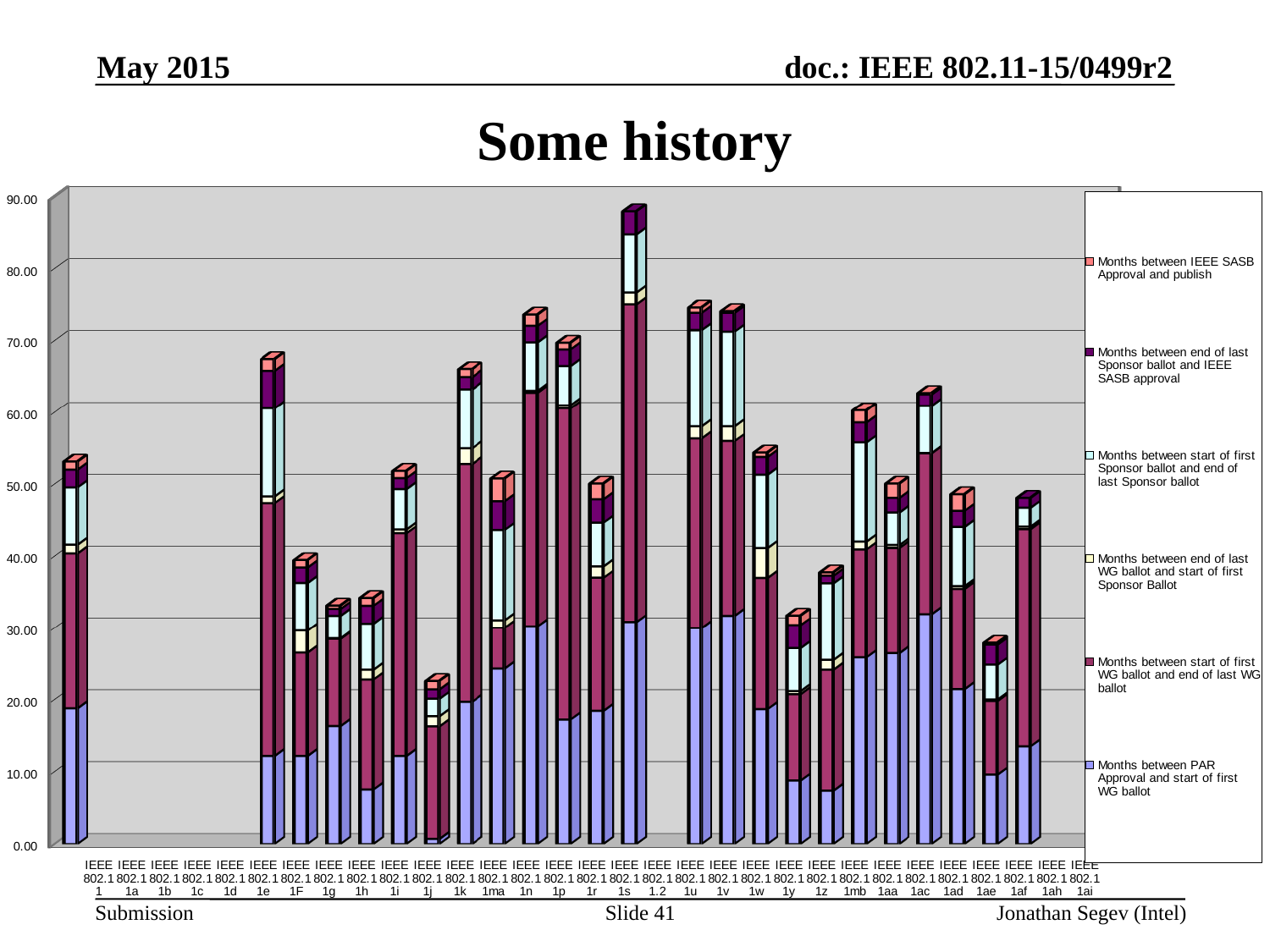
Which has the taller stacked bar, IEEE 802.11s or IEEE 802.11e? IEEE 802.11s Is the total for IEEE 802.11j greater or less than 30? less How many series does the legend list? 6 Is the total for IEEE 802.11s greater or less than 80? greater What kind of chart is shown on the slide? Stacked bar chart What is the title of the chart? Some history Is the total for IEEE 802.11e greater or less than 60? greater Which category has the tallest stacked bar? IEEE 802.11s Which has the taller stacked bar, IEEE 802.11i or IEEE 802.11j? IEEE 802.11i Which series is listed last in the legend? Months between PAR Approval and start of first WG ballot